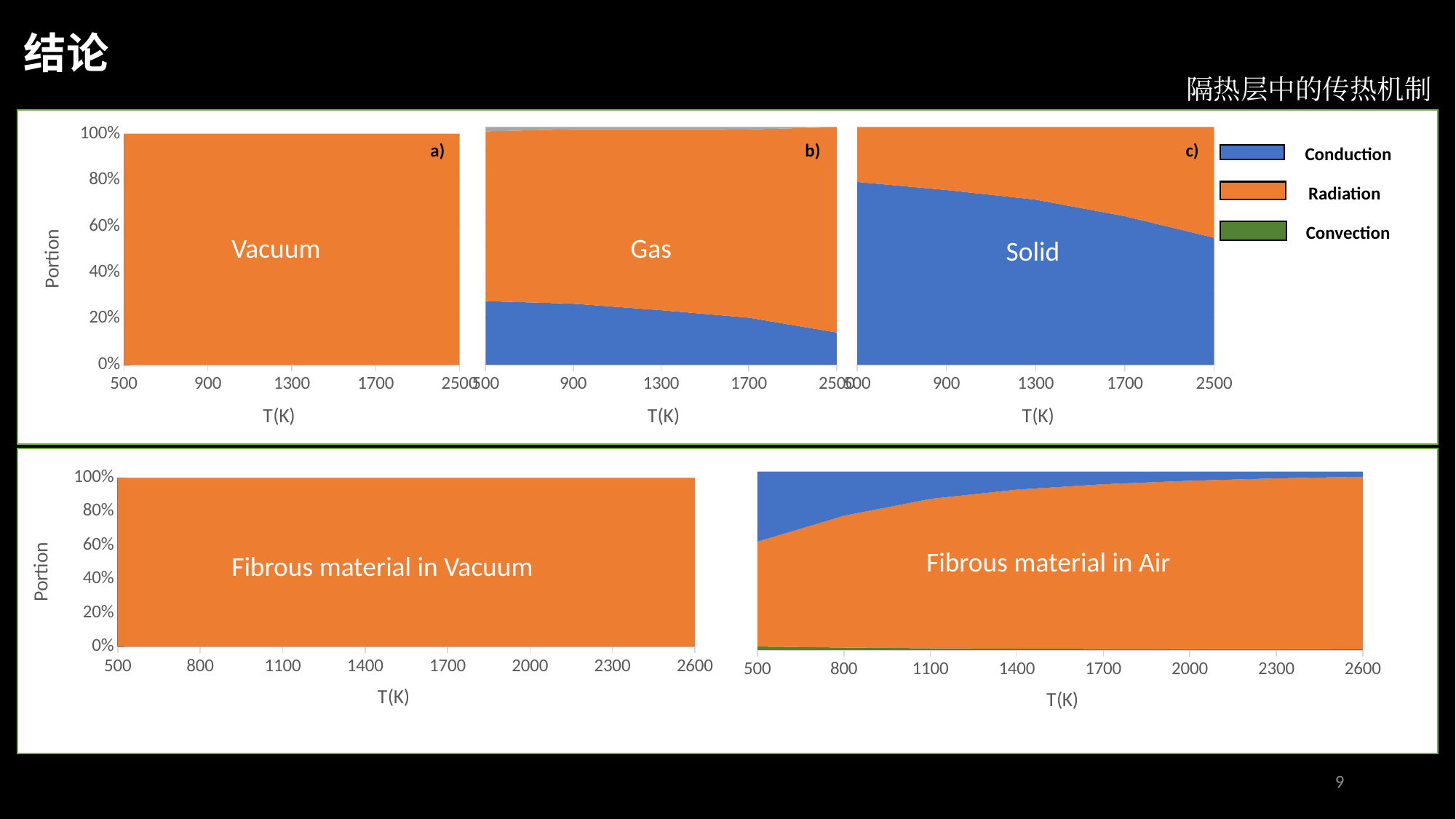
In the 'Gas' chart (b), is the Conduction portion at 500 K greater or less than 20%? greater In the 'Solid' chart (c), is the Conduction portion at 500 K greater or less than 60%? greater What kind of chart is the 'Solid' chart (c)? stacked area chart How many series does the legend list for the top row of charts? 3 What is the highest temperature tick shown on the x axis of the 'Fibrous material in Vacuum' chart? 2600 In the 'Fibrous material in Air' chart, does the Radiation portion rise or fall as temperature increases? rise In the 'Gas' chart (b), is the Conduction portion at 2500 K greater or less than 20%? less In the 'Solid' chart (c), does the Conduction portion rise or fall as temperature increases? fall In the legend, which colour represents Conduction? blue Among the three top-row charts (Vacuum, Gas, Solid), which has the largest Conduction portion at 500 K? Solid In the 'Vacuum' chart (a), which heat transfer mechanism accounts for the entire portion across all temperatures? Radiation